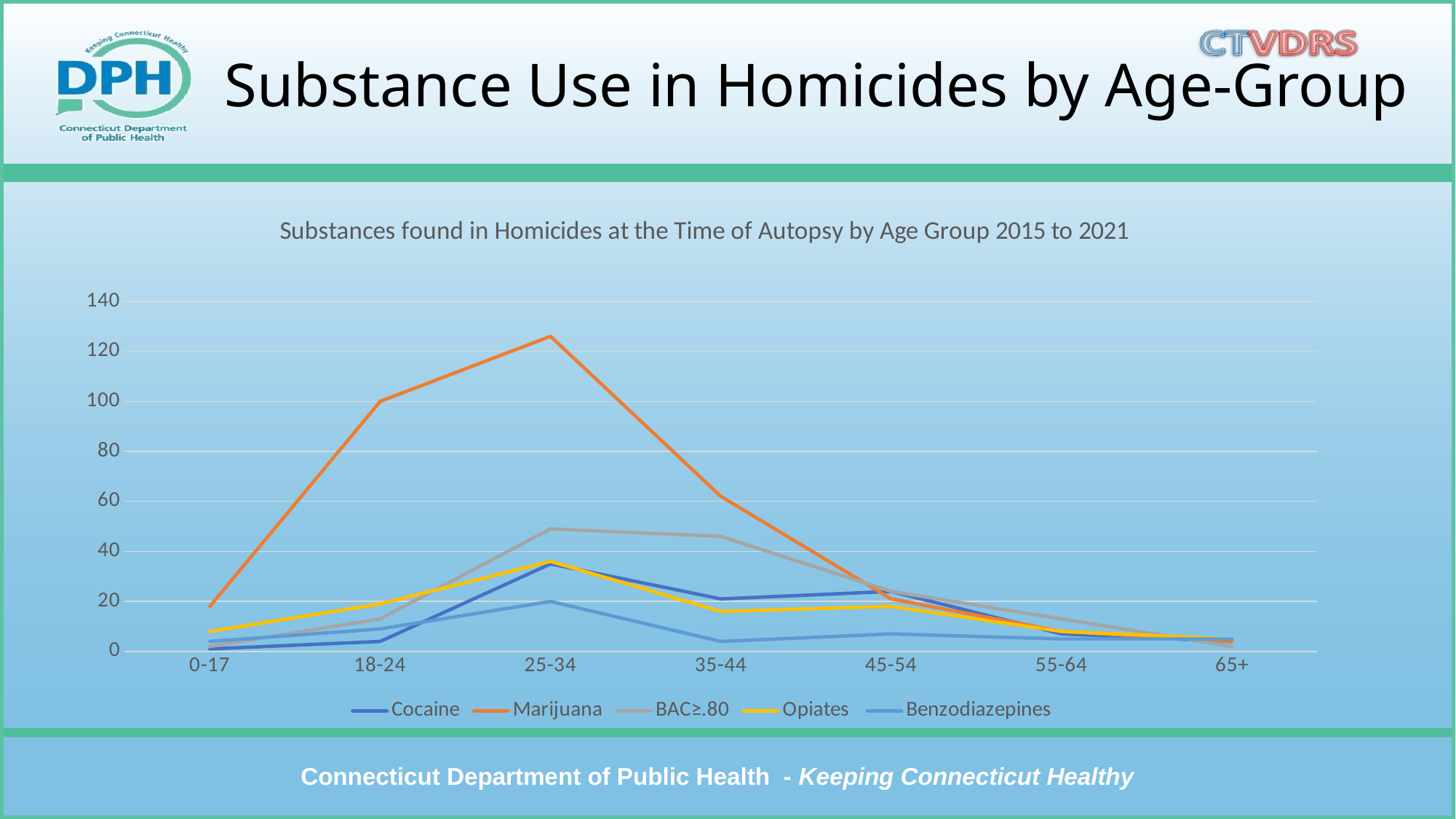
Is the value for Marijuana in the 35-44 age group greater or less than 80? less What kind of chart is shown on the slide? line chart Which substance has the highest value in the 25-34 age group? Marijuana Is the value for Opiates in the 0-17 age group greater or less than 20? less Which age group has the highest value for Marijuana? 25-34 Is the value for Marijuana in the 25-34 age group greater or less than 120? greater Does the Marijuana line rise or fall from the 25-34 age group to the 65+ age group? fall Which is larger in the 18-24 age group, Marijuana or Cocaine? Marijuana How many age groups are shown on the x axis? 7 Which age group has the lowest value for Marijuana? 65+ How many series does the legend list? 5